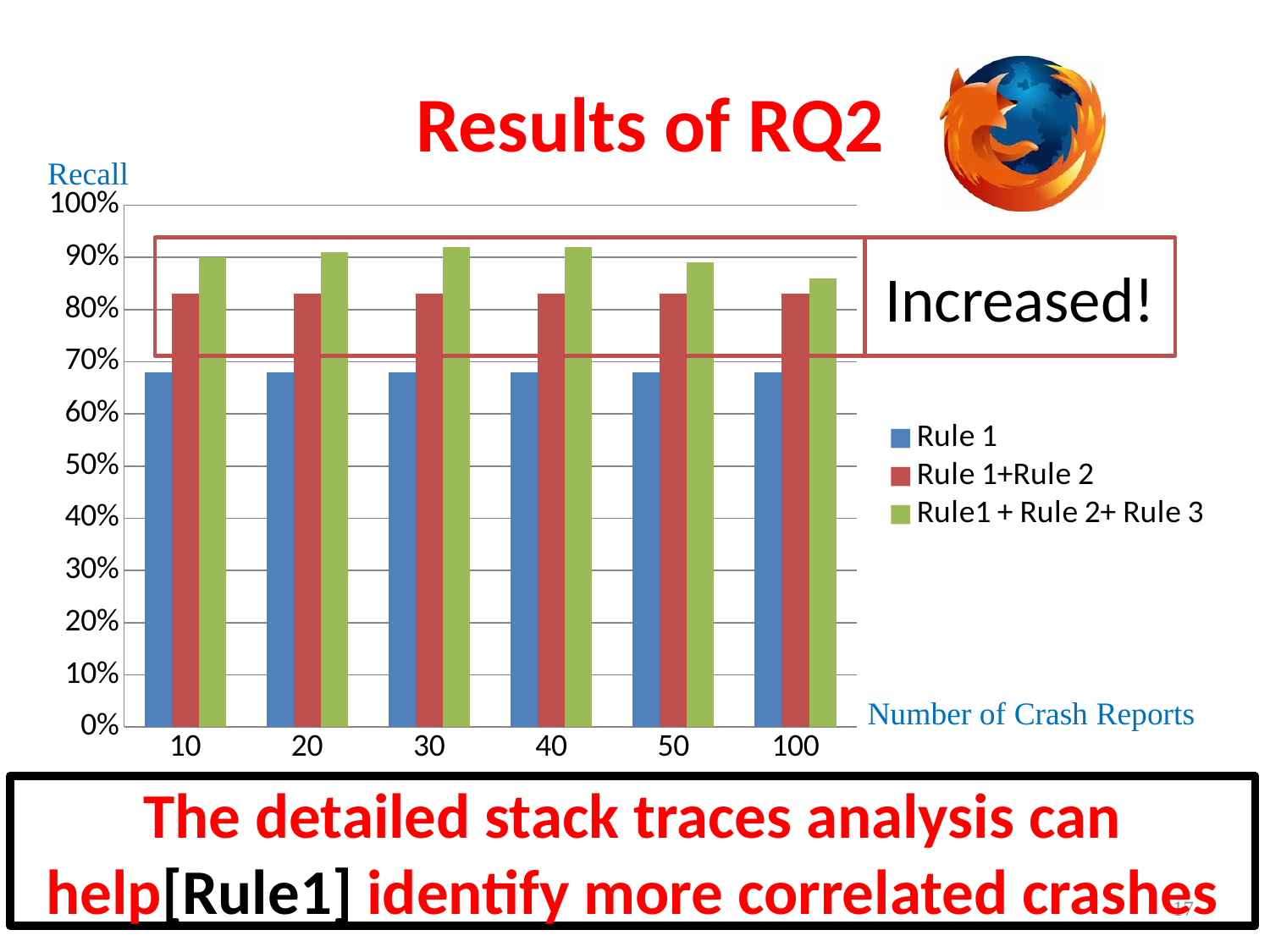
Is the value for Rule 1+Rule 2 at 20 crash reports greater or less than 80%? greater What is the label on the y axis of the chart? Recall Is the value for Rule1 + Rule 2+ Rule 3 at 100 crash reports greater or less than 90%? less Is the value for Rule 1 at 10 crash reports greater or less than 60%? greater How many categories (numbers of crash reports) are shown on the x axis? 6 Which series has the lowest value at 50 crash reports? Rule 1 What kind of chart is shown on the slide? bar chart Which series has the highest value at 40 crash reports? Rule1 + Rule 2+ Rule 3 At 10 crash reports, which is larger: Rule 1 or Rule1 + Rule 2+ Rule 3? Rule1 + Rule 2+ Rule 3 How many series does the legend list? 3 What is the label on the x axis of the chart? Number of Crash Reports